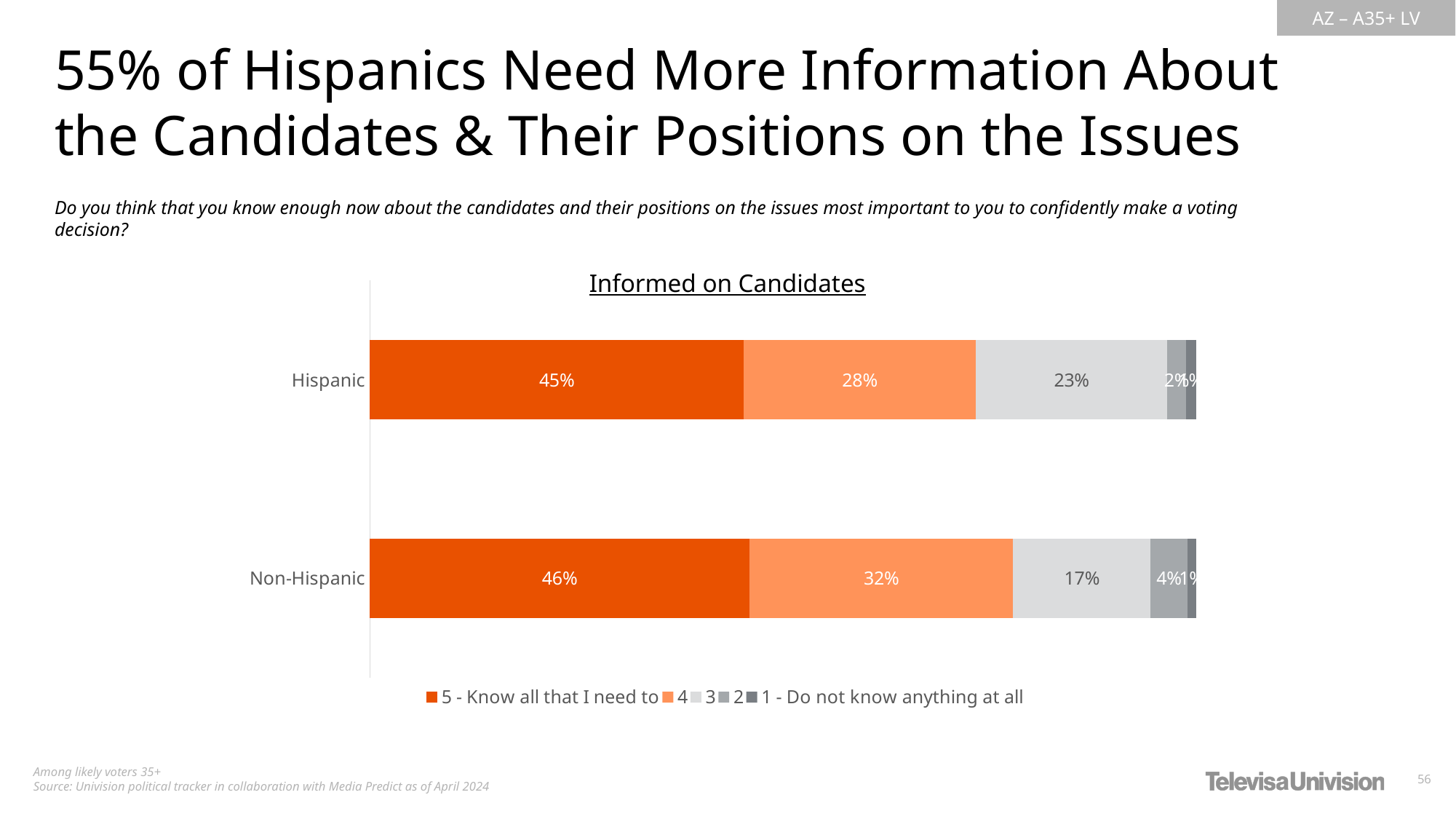
What is the title of the chart? Informed on Candidates What is the difference between the Non-Hispanic and Hispanic shares answering '4'? 4 percentage points What percentage of Hispanic respondents answered '5 - Know all that I need to'? 45% What percentage of Hispanic respondents answered '3'? 23% What kind of chart is shown on the slide? Stacked bar chart What is the difference between the Hispanic and Non-Hispanic shares answering '3'? 6 percentage points What percentage of Non-Hispanic respondents answered '2'? 4% How many categories (bars) does the chart show? 2 What percentage of Non-Hispanic respondents answered '4'? 32% Which group has the larger share answering '4', Hispanic or Non-Hispanic? Non-Hispanic How many series does the legend list? 5 Which response has the largest share among Non-Hispanic respondents? 5 - Know all that I need to